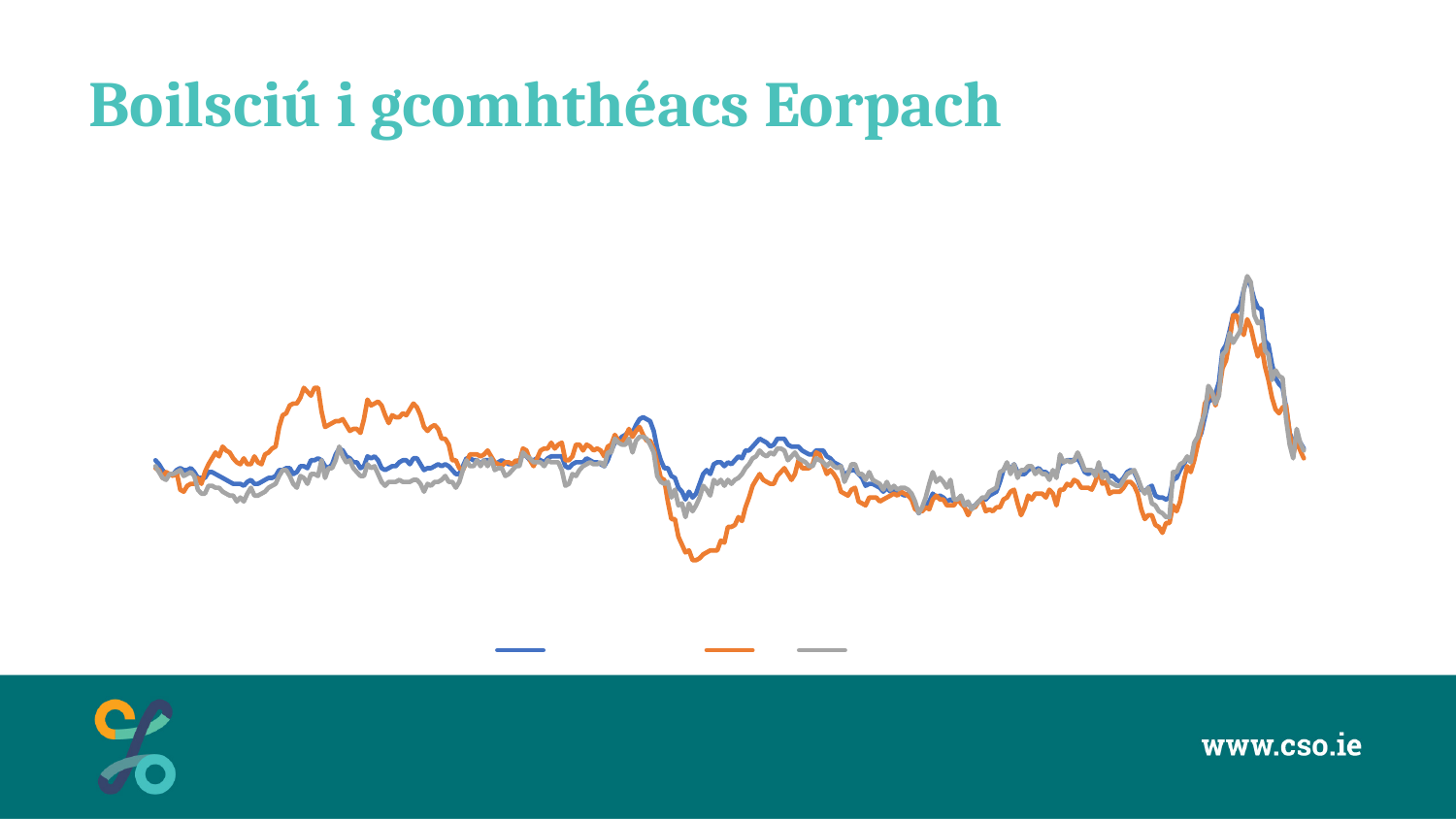
What colours are the three lines in the chart? blue, orange and grey Which line drops to the lowest point on the chart? the orange line How many series does the legend list? 3 What is the title of the slide? Boilsciú i gcomhthéacs Eorpach What kind of chart is shown on the slide? line chart